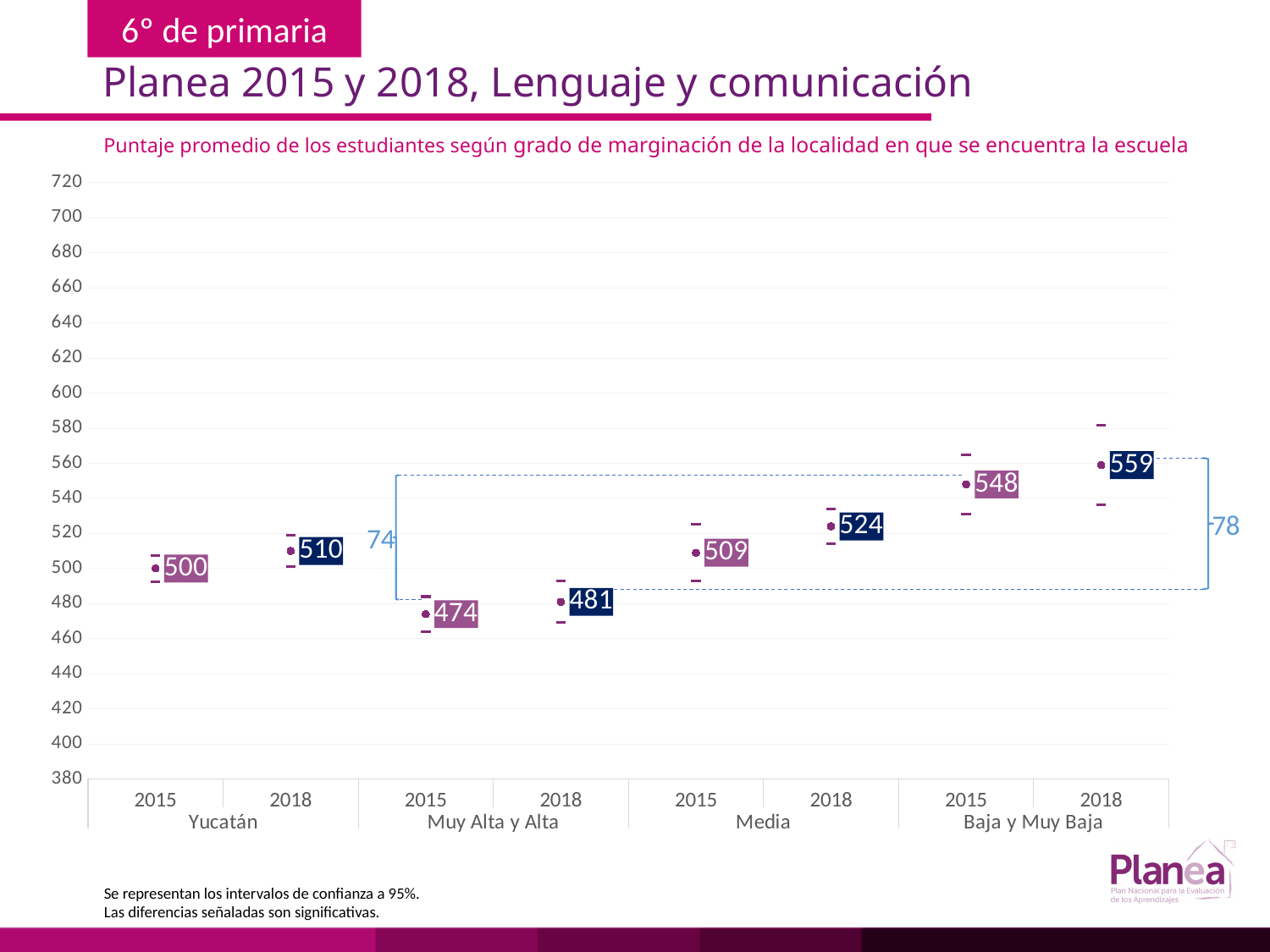
How many data points are plotted on the chart? 8 What difference is annotated between the 2018 scores of Baja y Muy Baja and Muy Alta y Alta? 78 Which is larger, the 2018 score for Media or the 2015 score for Baja y Muy Baja? 2015 score for Baja y Muy Baja (548) What is the average score for Yucatán in 2015? 500 What is the average score for Baja y Muy Baja marginación in 2015? 548 What is the average score for Media marginación in 2018? 524 What is the difference between the 2018 and 2015 scores for Media marginación? 15 Which group and year has the highest average score? Baja y Muy Baja, 2018 (559) What is the difference between the 2018 and 2015 scores for Yucatán? 10 Which group and year has the lowest average score? Muy Alta y Alta, 2015 (474) What is the average score for Muy Alta y Alta marginación in 2018? 481 Does the score rise or fall from 2015 to 2018 within each marginación group? Rises